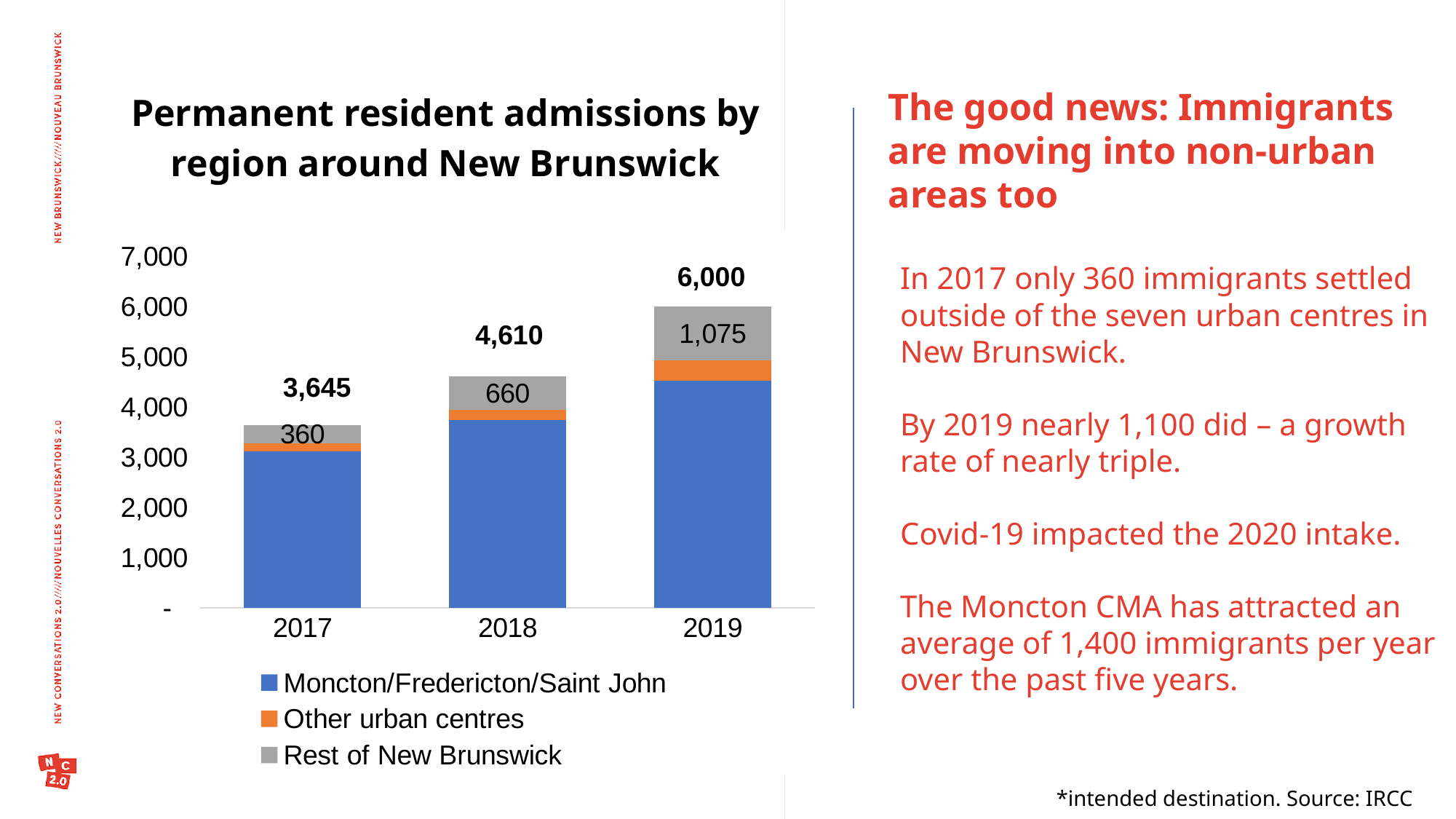
Which year has the lowest total admissions? 2017 What is the total permanent resident admissions shown for 2019? 6,000 Which year has the highest total admissions? 2019 What value is labelled for Rest of New Brunswick in 2019? 1,075 How many years are shown on the x axis? 3 What kind of chart is shown on the slide? Stacked bar chart What value is labelled for Rest of New Brunswick in 2018? 660 Is the Moncton/Fredericton/Saint John value for 2019 greater or less than 4,000? greater What is the total permanent resident admissions shown for 2017? 3,645 What is the difference between the total admissions in 2019 and 2017? 2,355 By how much did the Rest of New Brunswick value increase from 2017 to 2019? 715 How many series does the legend list? 3